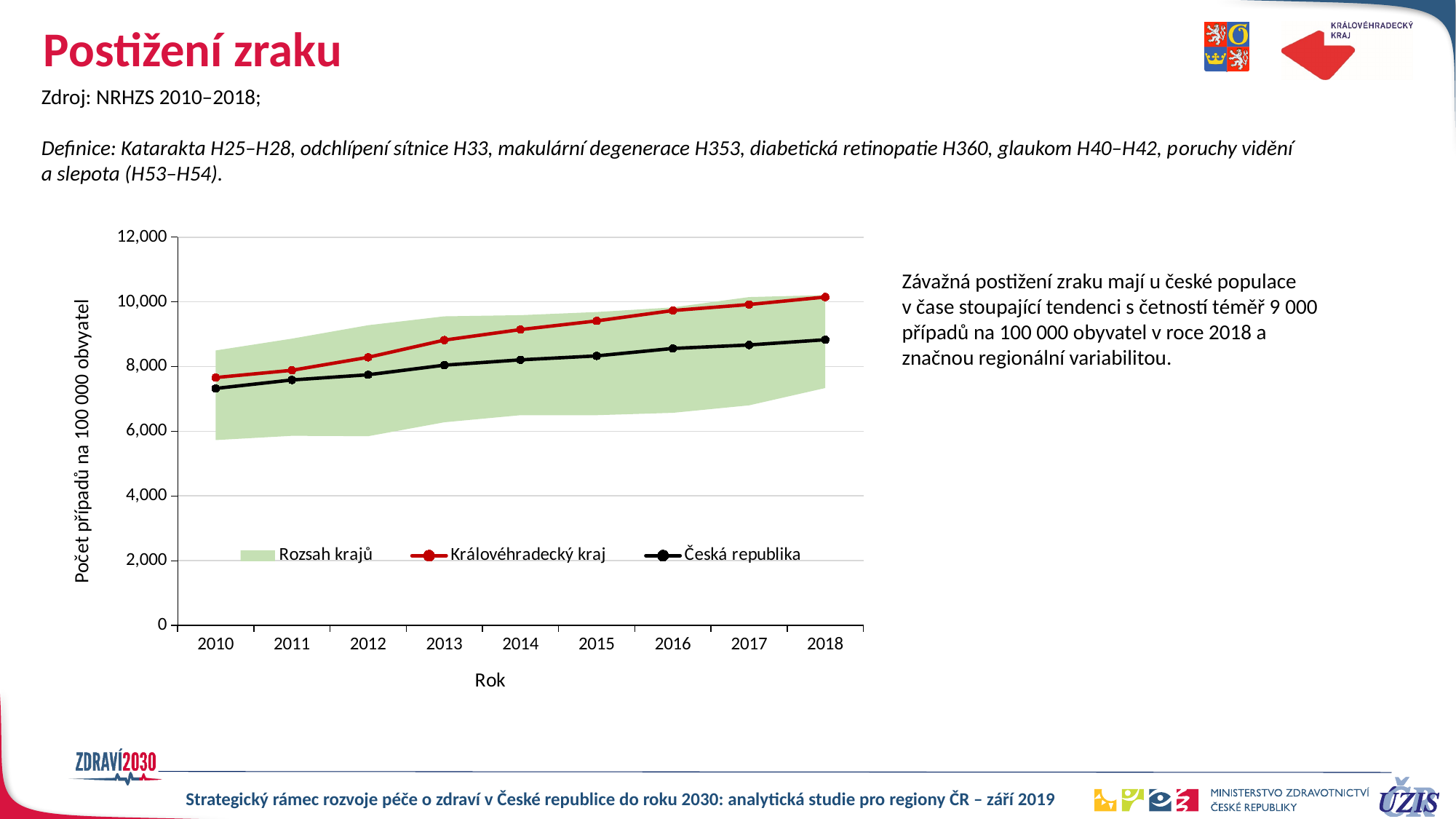
In which year is the value for Česká republika lowest? 2010 What kind of chart is shown on the slide? line chart How many years are plotted along the x axis of the chart? 9 Is the value for Královéhradecký kraj in 2016 greater or less than 10,000? less What is the label of the y axis of the chart? Počet případů na 100 000 obyvatel In which year is the value for Královéhradecký kraj highest? 2018 In 2018, which is larger: the value for Královéhradecký kraj or for Česká republika? Královéhradecký kraj Is the value for Královéhradecký kraj in 2010 greater or less than 8,000? less How many entries does the chart legend list? 3 Does the Česká republika series rise or fall over the years shown? rise Does the Královéhradecký kraj series rise or fall from 2010 to 2018? rise Is the value for Česká republika in 2018 greater or less than 8,000? greater